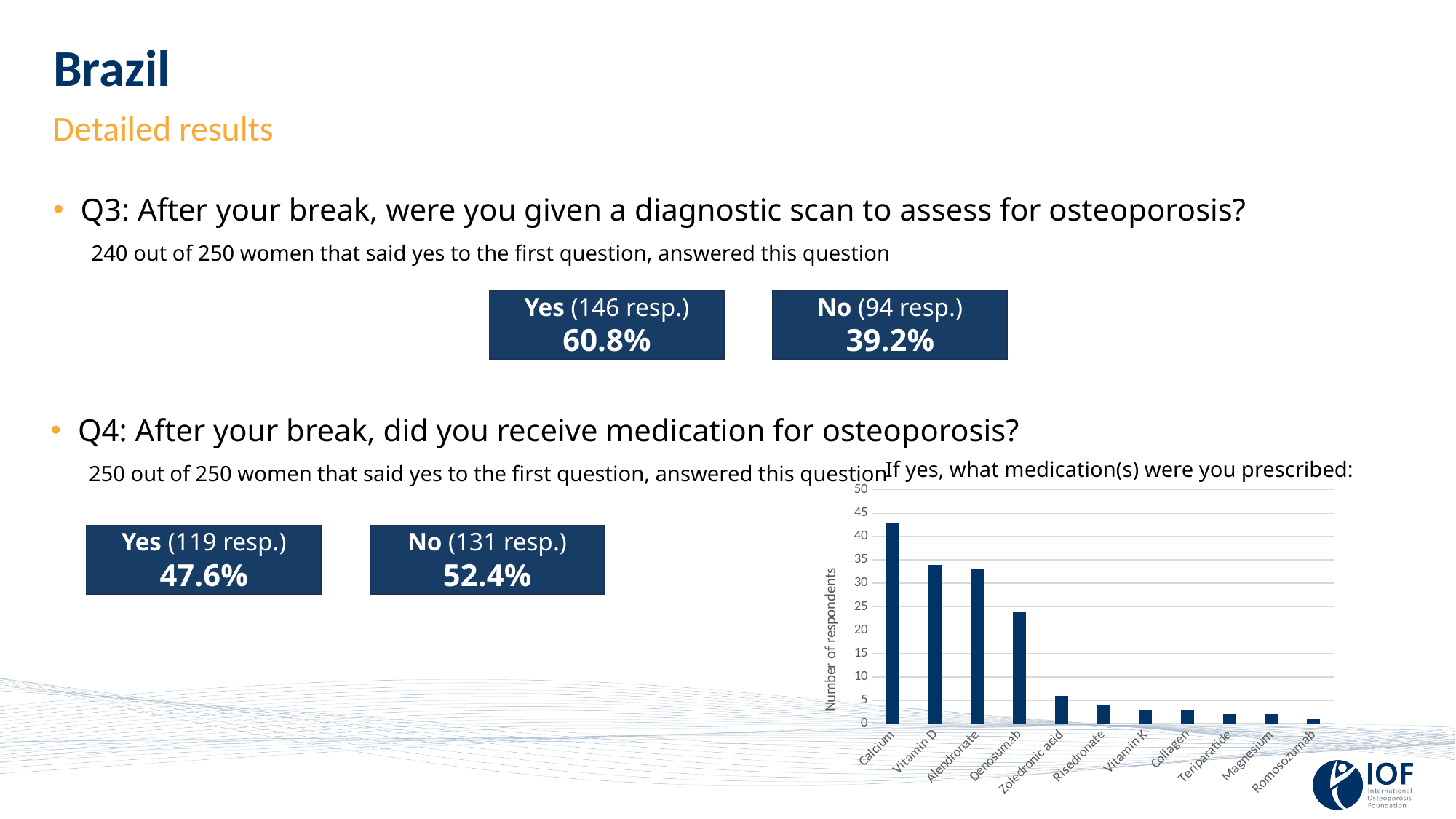
Do the values in the chart generally rise or fall from left to right along the x axis? fall Is the value for Calcium greater or less than 45? less Is the value for Calcium greater or less than 40? greater Which medication has the lowest number of respondents in the chart? Romosozumab Is the value for Vitamin D greater or less than 30? greater How many medication categories are shown on the x axis of the chart? 11 Which is larger, the value for Calcium or the value for Denosumab? Calcium What kind of chart is shown on the slide? bar chart Which medication has the highest number of respondents in the chart? Calcium